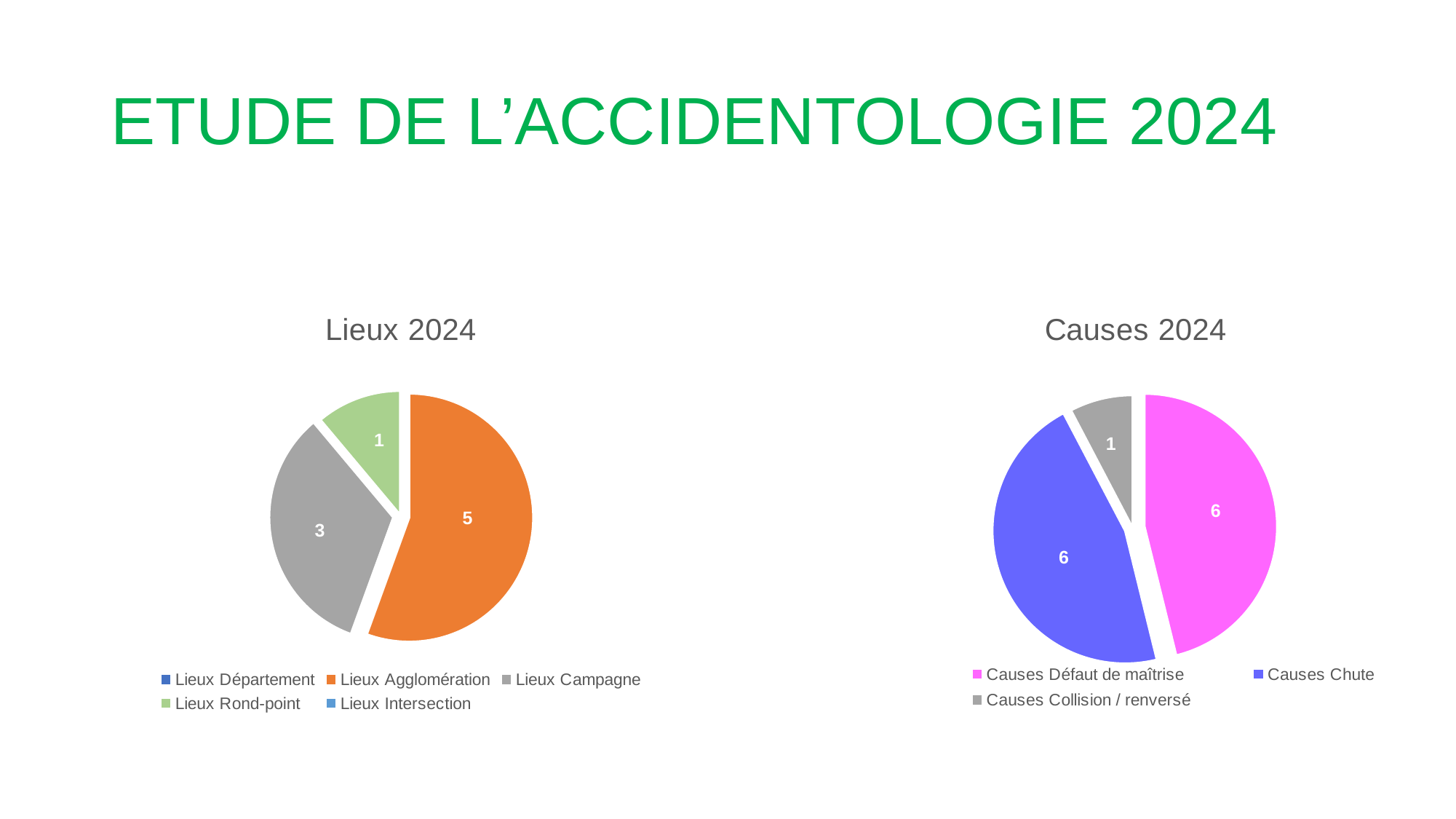
In the Lieux 2024 chart, which is larger: Lieux Campagne or Lieux Rond-point? Lieux Campagne What kind of chart is the Causes 2024 chart? Pie chart In the Lieux 2024 chart, what is the value for Lieux Agglomération? 5 In the Lieux 2024 chart, which category has the largest slice? Lieux Agglomération In the Causes 2024 chart, what is the value for Causes Défaut de maîtrise? 6 In the Causes 2024 chart, which category has the smallest slice? Causes Collision / renversé In the Lieux 2024 chart, how many entries does the legend list? 5 In the Lieux 2024 chart, what is the value for Lieux Rond-point? 1 In the Lieux 2024 chart, what is the difference between the values for Lieux Agglomération and Lieux Campagne? 2 In the Lieux 2024 chart, what is the value for Lieux Campagne? 3 In the Causes 2024 chart, what is the value for Causes Collision / renversé? 1 In the Lieux 2024 chart, how many slices are shown in the pie? 3